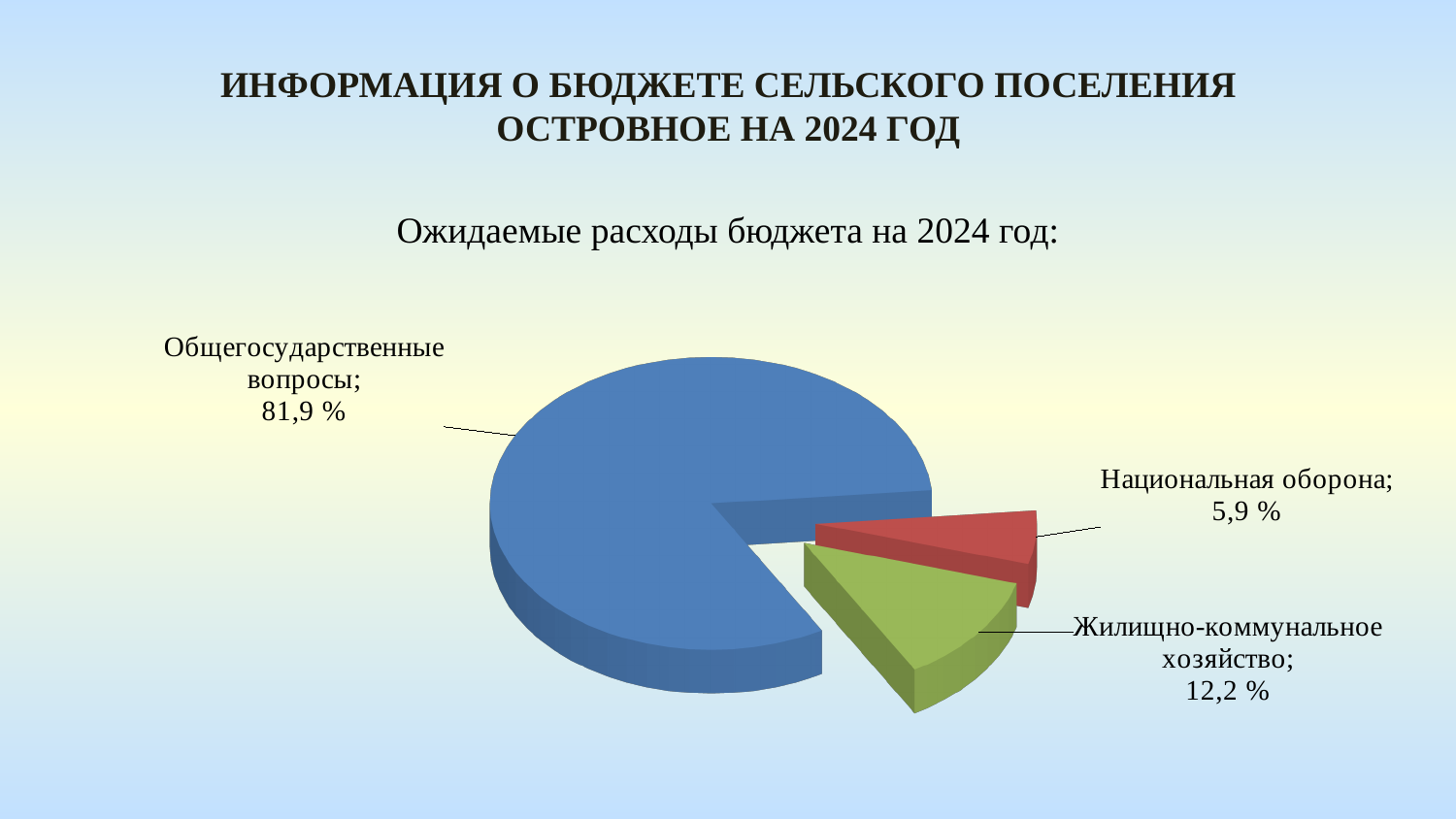
What share of the pie does Общегосударственные вопросы have? 81,9 % What kind of chart is shown on the slide? Pie chart How many categories are shown in the pie chart? 3 Which category has the smallest slice of the pie? Национальная оборона What is the difference in percentage points between Общегосударственные вопросы and Жилищно-коммунальное хозяйство? 69,7 What is the difference in percentage points between Жилищно-коммунальное хозяйство and Национальная оборона? 6,3 What is the subtitle above the chart? Ожидаемые расходы бюджета на 2024 год: Which category has the largest slice of the pie? Общегосударственные вопросы What colour is the slice for Общегосударственные вопросы? Blue What share of the pie does Национальная оборона have? 5,9 % What share of the pie does Жилищно-коммунальное хозяйство have? 12,2 % Which is larger: the share for Жилищно-коммунальное хозяйство or the share for Национальная оборона? Жилищно-коммунальное хозяйство